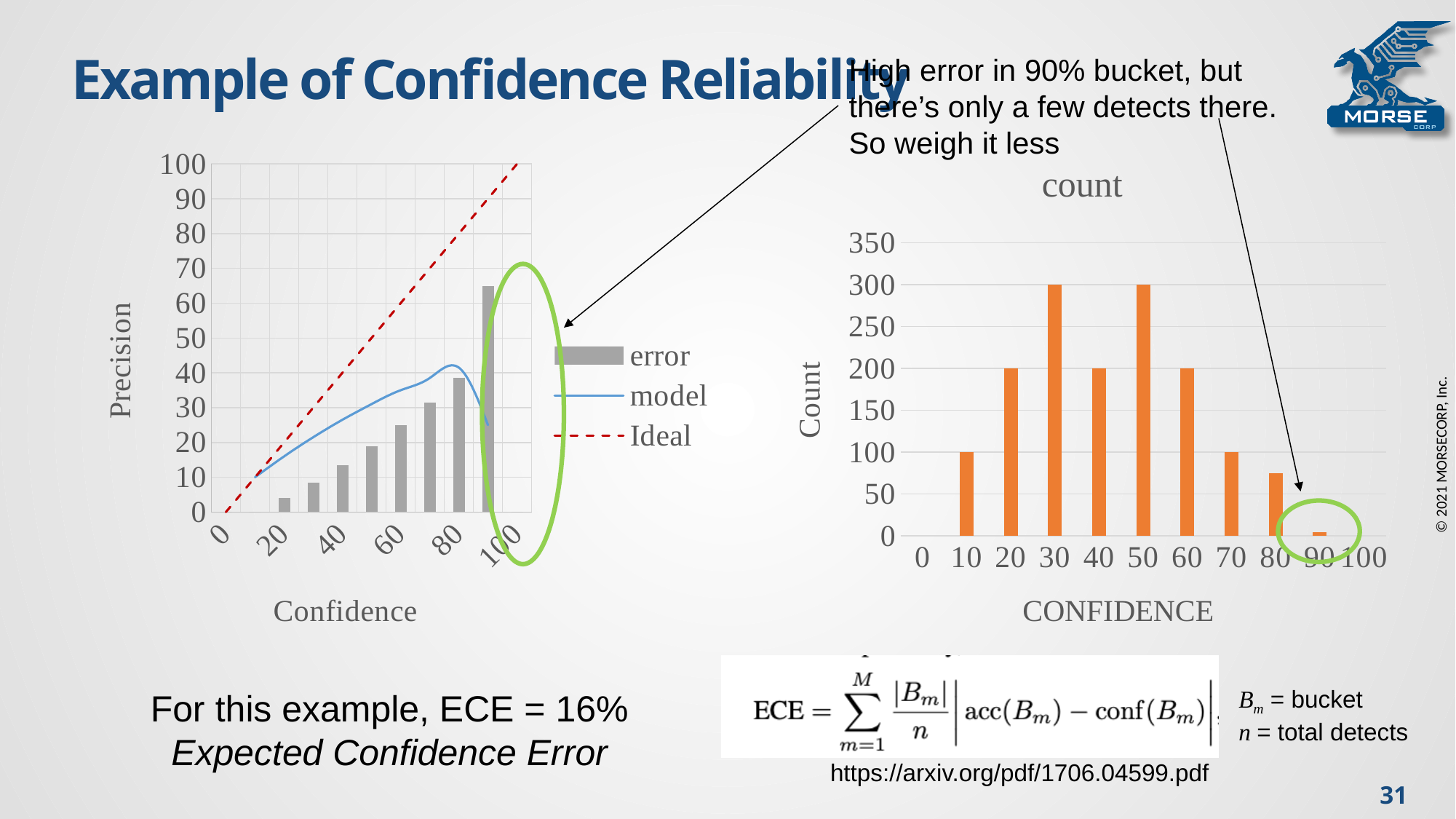
On the 'count' chart on the right, what is the count for the 30 confidence bucket? 300 What kind of chart is the 'count' chart on the right? bar chart On the left chart (Precision vs Confidence), how many series does the legend list? 3 On the left chart (Precision vs Confidence), is the error bar at confidence 90 greater or less than 60? greater On the 'count' chart on the right, what is the count for the 10 confidence bucket? 100 On the 'count' chart on the right, which confidence bucket has the lowest count? 90 On the 'count' chart on the right, how many bars are plotted? 9 On the 'count' chart on the right, which has a larger count, the 20 bucket or the 70 bucket? 20 On the 'count' chart on the right, is the count for the 80 bucket greater or less than 100? less On the 'count' chart on the right, what is the difference between the counts for the 50 and 70 buckets? 200 On the 'count' chart on the right, what is the count for the 60 confidence bucket? 200 On the left chart (Precision vs Confidence), at which confidence value is the error bar highest? 90